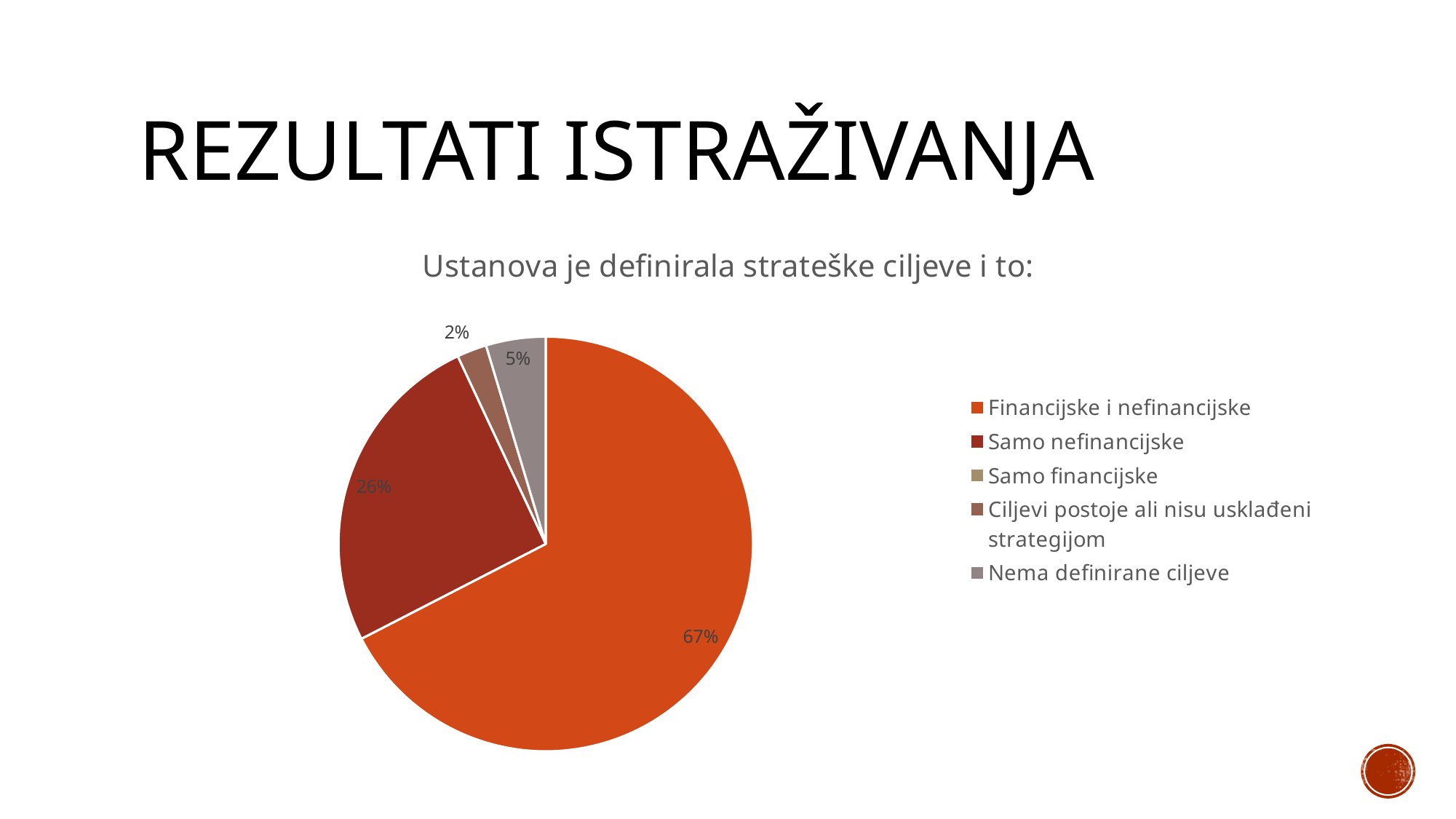
What share of the pie is labelled for 'Financijske i nefinancijske'? 67% What percentage is shown for 'Nema definirane ciljeve'? 5% How many entries does the legend list? 5 What percentage is shown for 'Samo nefinancijske'? 26% Which category has the largest slice of the pie? Financijske i nefinancijske Is the share for 'Samo nefinancijske' greater or less than 50%? less What kind of chart is shown on the slide? Pie chart What percentage is shown for 'Ciljevi postoje ali nisu usklađeni strategijom'? 2% What colour is the slice for 'Nema definirane ciljeve'? Grey Which is larger: the slice for 'Samo nefinancijske' or the slice for 'Nema definirane ciljeve'? Samo nefinancijske What is the title of the chart? Ustanova je definirala strateške ciljeve i to: What is the difference in percentage points between 'Financijske i nefinancijske' and 'Samo nefinancijske'? 41 percentage points